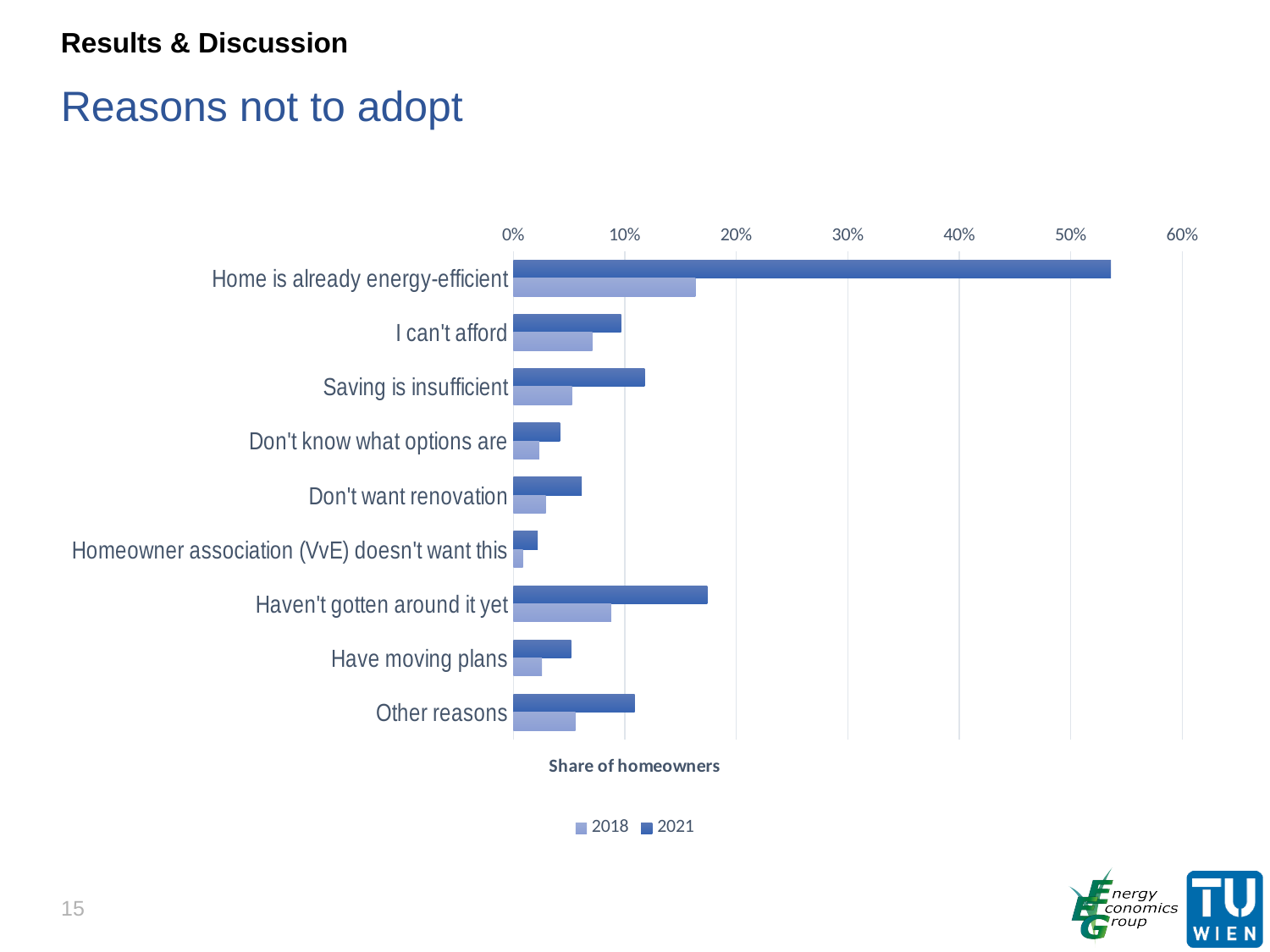
What is the title of the horizontal axis? Share of homeowners What kind of chart is shown on the slide? Bar chart Which reason has the lowest share of homeowners in 2021? Homeowner association (VvE) doesn't want this Is the 2021 value for 'Haven't gotten around it yet' greater or less than 10%? greater Which series is shown in the lighter blue colour? 2018 Which reason has the highest share of homeowners in 2021? Home is already energy-efficient Is the 2021 value for 'Home is already energy-efficient' greater or less than 50%? greater How many series does the legend list? 2 How many reasons (categories) are plotted on the chart? 9 Is the 2018 value for 'Home is already energy-efficient' greater or less than 20%? less For 'Home is already energy-efficient', which year has the larger share, 2018 or 2021? 2021 In 2021, which reason has the larger share: 'Haven't gotten around it yet' or 'Other reasons'? Haven't gotten around it yet